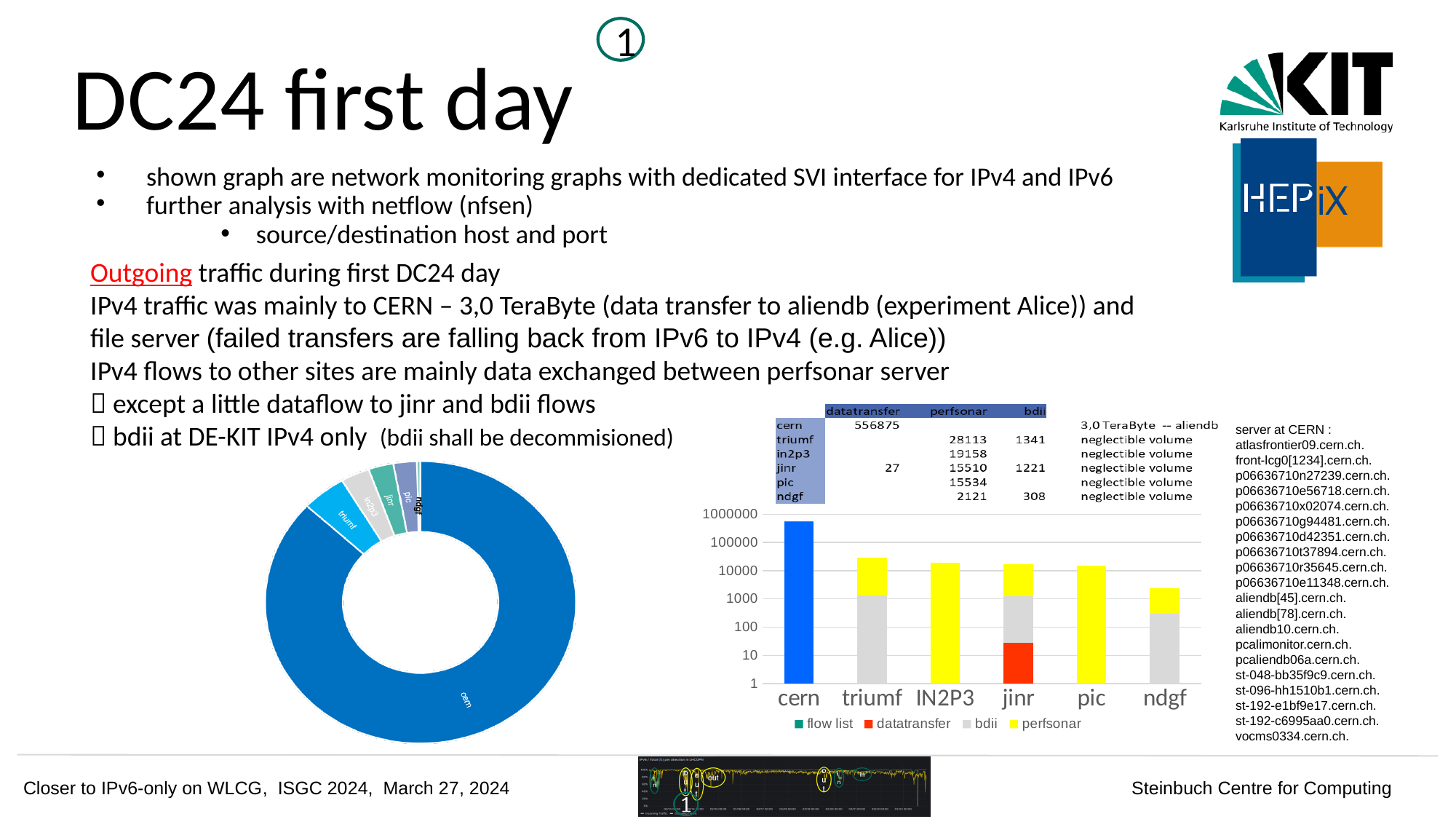
In the bar chart on the right, what colour does the legend use for the perfsonar series? yellow According to the table above the bar chart on the right, what is the datatransfer value for jinr? 27 In the bar chart on the right, which site has the lowest total bar? ndgf What kind of chart is the chart on the right of the slide, with categories cern, triumf, IN2P3, jinr, pic and ndgf? stacked bar chart In the doughnut chart on the left, which site has the largest segment? cern In the bar chart on the right, is the total height of the ndgf bar greater or less than 10000? less In the bar chart on the right, which bar is taller in total, triumf or ndgf? triumf According to the table above the bar chart on the right, what is the perfsonar value for triumf? 28113 In the bar chart on the right, how many series does the legend list? 4 What kind of chart is the chart on the left of the slide, with the large cern segment? doughnut chart In the bar chart on the right, is the value for cern greater or less than 100000? greater In the bar chart on the right, how many site categories are shown on the x axis? 6